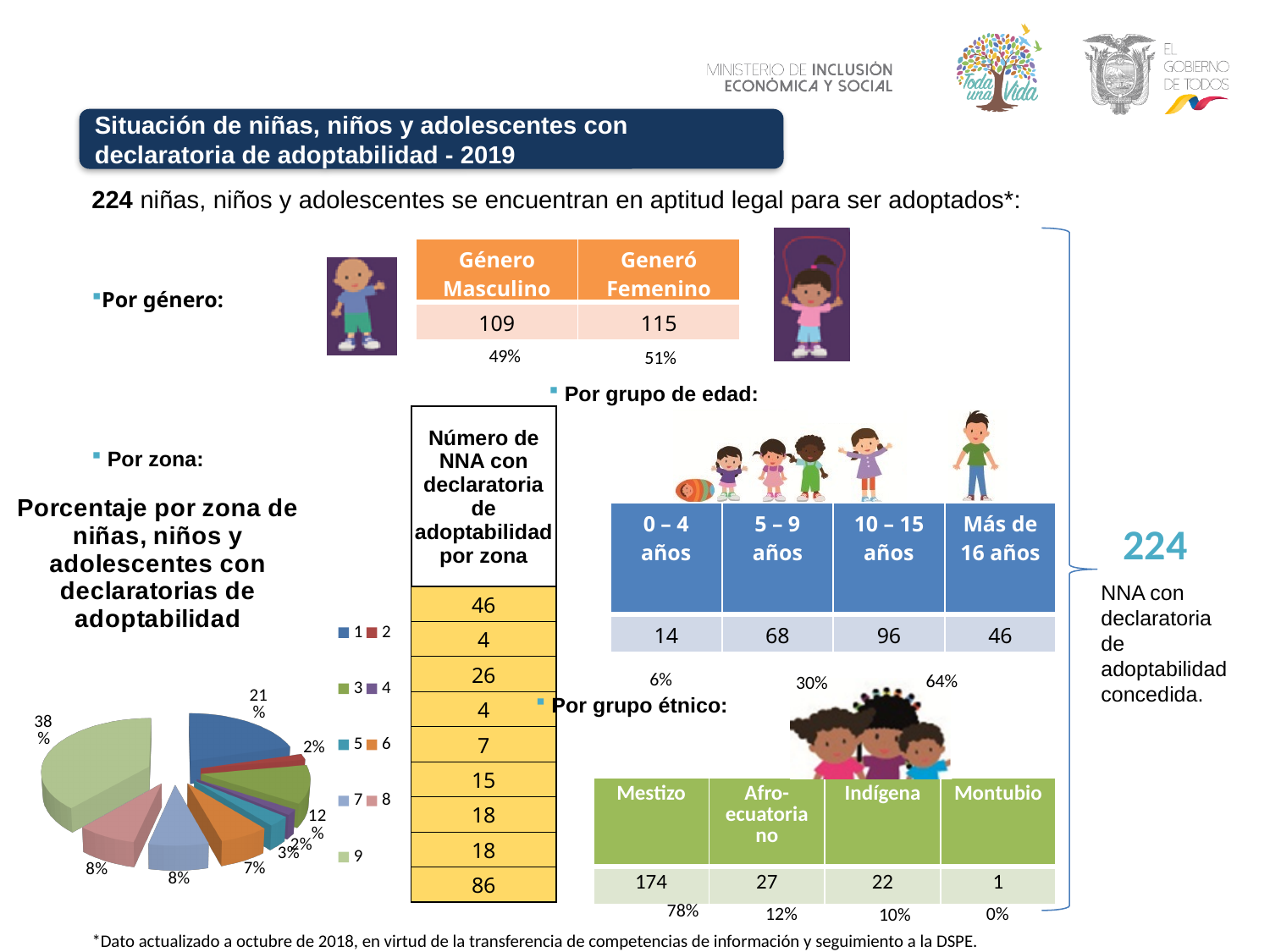
What is the largest percentage shown on the pie chart? 38% How many slices does the pie chart have? 9 What kind of chart is shown on the slide? Pie chart What is the title of the pie chart? Porcentaje por zona de niñas, niños y adolescentes con declaratorias de adoptabilidad Which has the larger share in the pie chart, category 1 or category 3? 1 What percentage is shown for category 3 in the pie chart? 12% What percentage is shown for category 1 in the pie chart? 21% What is the smallest percentage shown on the pie chart? 2% What is the difference in percentage points between the largest slice (38%) and the 21% slice in the pie chart? 17 What percentage is shown for category 9 in the pie chart? 38% Which legend category has the largest slice in the pie chart? 9 How many entries does the pie chart's legend list? 9